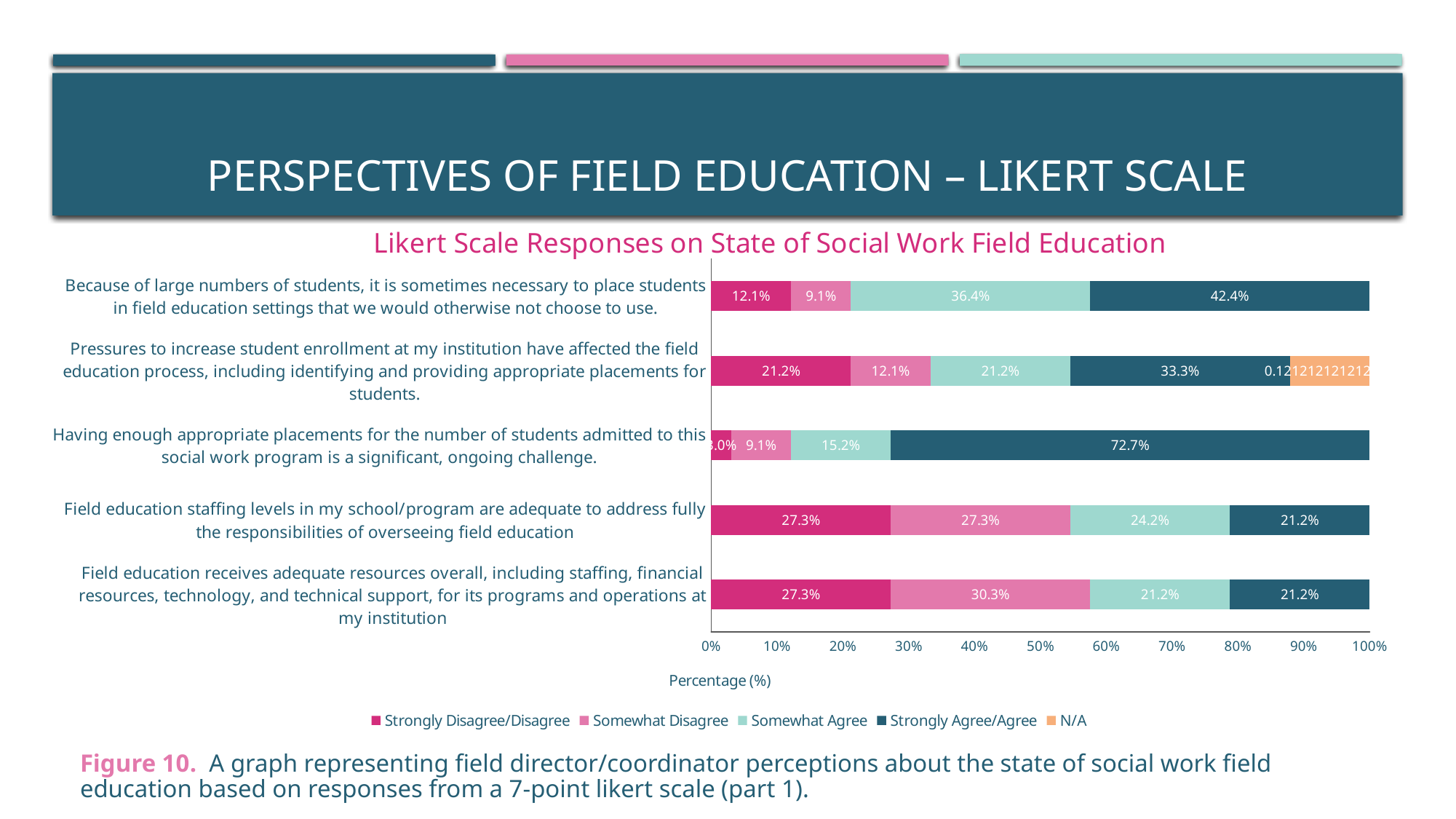
Which statement has the lowest Strongly Disagree/Disagree percentage? Having enough appropriate placements for the number of students admitted to this social work program is a significant, ongoing challenge. What is the title of the chart? Likert Scale Responses on State of Social Work Field Education Which statement has the highest Strongly Agree/Agree percentage? Having enough appropriate placements for the number of students admitted to this social work program is a significant, ongoing challenge. What is the Somewhat Agree percentage for the statement beginning 'Because of large numbers of students'? 36.4% Which is larger: the Somewhat Disagree percentage for the statement beginning 'Field education staffing levels' or for the statement beginning 'Field education receives adequate resources overall'? Field education receives adequate resources overall What is the Somewhat Disagree percentage for the statement beginning 'Field education receives adequate resources overall'? 30.3% What is the Strongly Agree/Agree percentage for the statement 'Having enough appropriate placements for the number of students admitted to this social work program is a significant, ongoing challenge.'? 72.7% How many series does the chart legend list? 5 How many statements (categories) are plotted in the chart? 5 What is the difference between the Strongly Agree/Agree percentage for the statement beginning 'Because of large numbers of students' (42.4%) and the statement beginning 'Field education staffing levels' (21.2%)? 21.2% What type of chart is shown on the slide? Stacked bar chart What is the Strongly Disagree/Disagree percentage for the statement beginning 'Pressures to increase student enrollment'? 21.2%